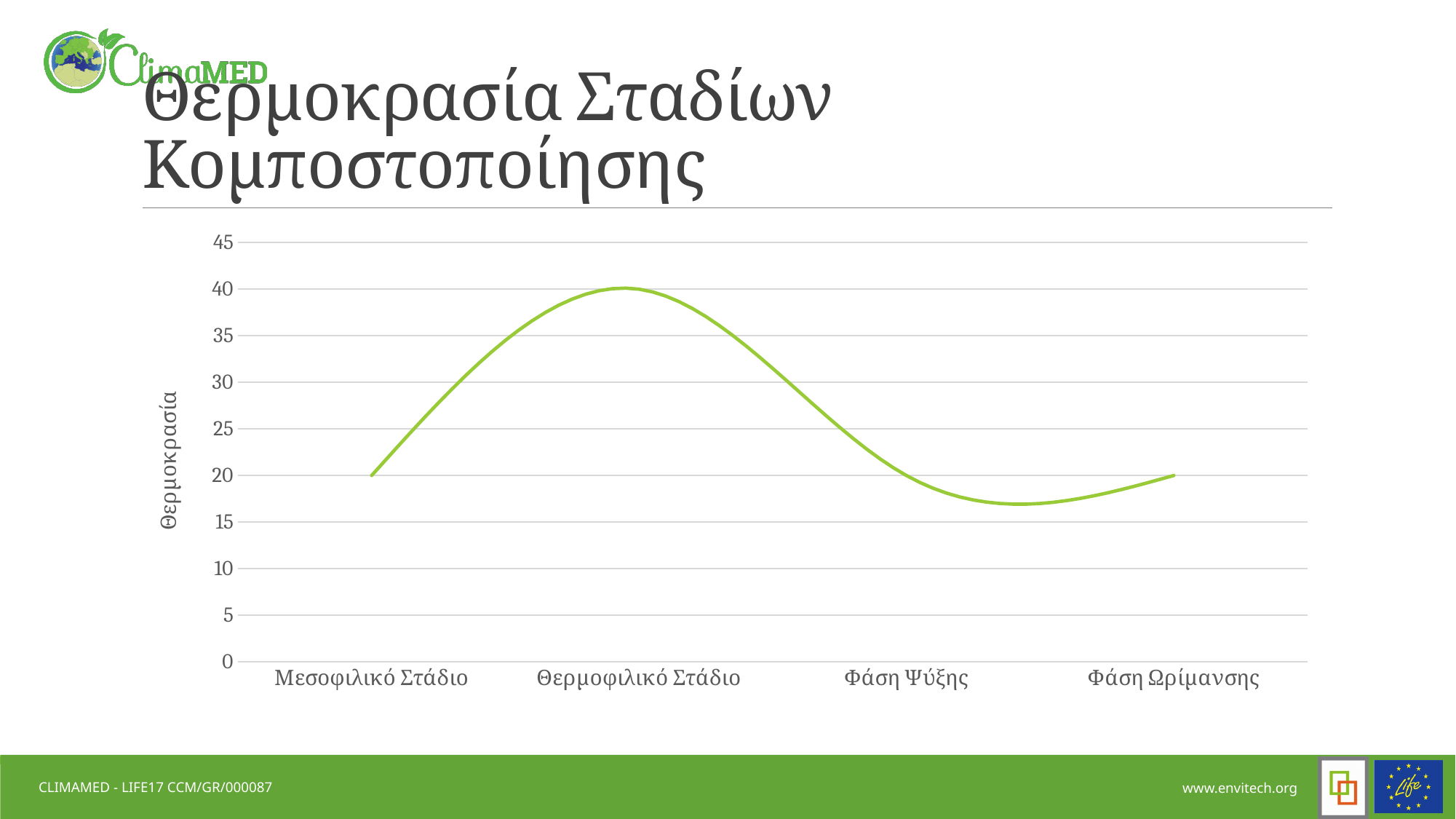
How many stages (categories) are shown on the x axis of the chart? 4 What is the value for Μεσοφιλικό Στάδιο? 20 What kind of chart is shown on the slide? line chart What is the value for Φάση Ωρίμανσης? 20 What is the difference between the values for Θερμοφιλικό Στάδιο and Μεσοφιλικό Στάδιο? 20 What is the label of the vertical axis? Θερμοκρασία Which stage has the highest temperature? Θερμοφιλικό Στάδιο Which is larger, the value for Θερμοφιλικό Στάδιο or the value for Φάση Ψύξης? Θερμοφιλικό Στάδιο What is the value for Θερμοφιλικό Στάδιο? 40 Is the value for Φάση Ψύξης greater or less than 15? greater